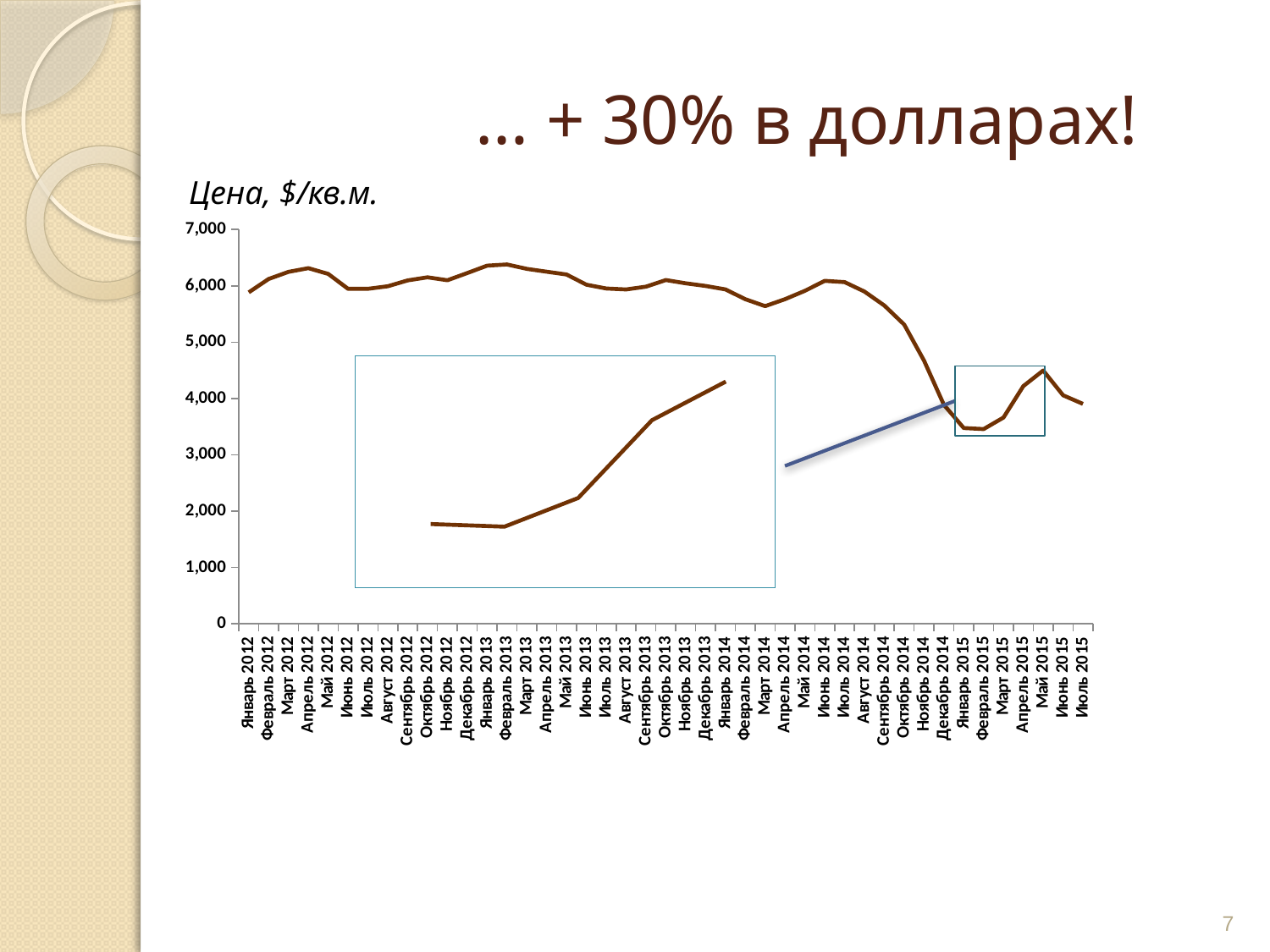
Do the values rise or fall from Январь 2015 to Май 2015? rise Is the value for Октябрь 2014 greater or less than 6,000? less Is the value for Май 2015 greater or less than 4,000? greater Is the value for Январь 2015 greater or less than 4,000? less What label is shown above the chart describing the plotted quantity? Цена, $/кв.м. What is the title of the slide above the chart? … + 30% в долларах! Which is larger, the value for Май 2015 or the value for Январь 2015? Май 2015 What kind of chart is shown on the slide? line chart Which is larger, the value for Апрель 2012 or the value for Июль 2015? Апрель 2012 Do the values rise or fall from Сентябрь 2014 to Январь 2015? fall